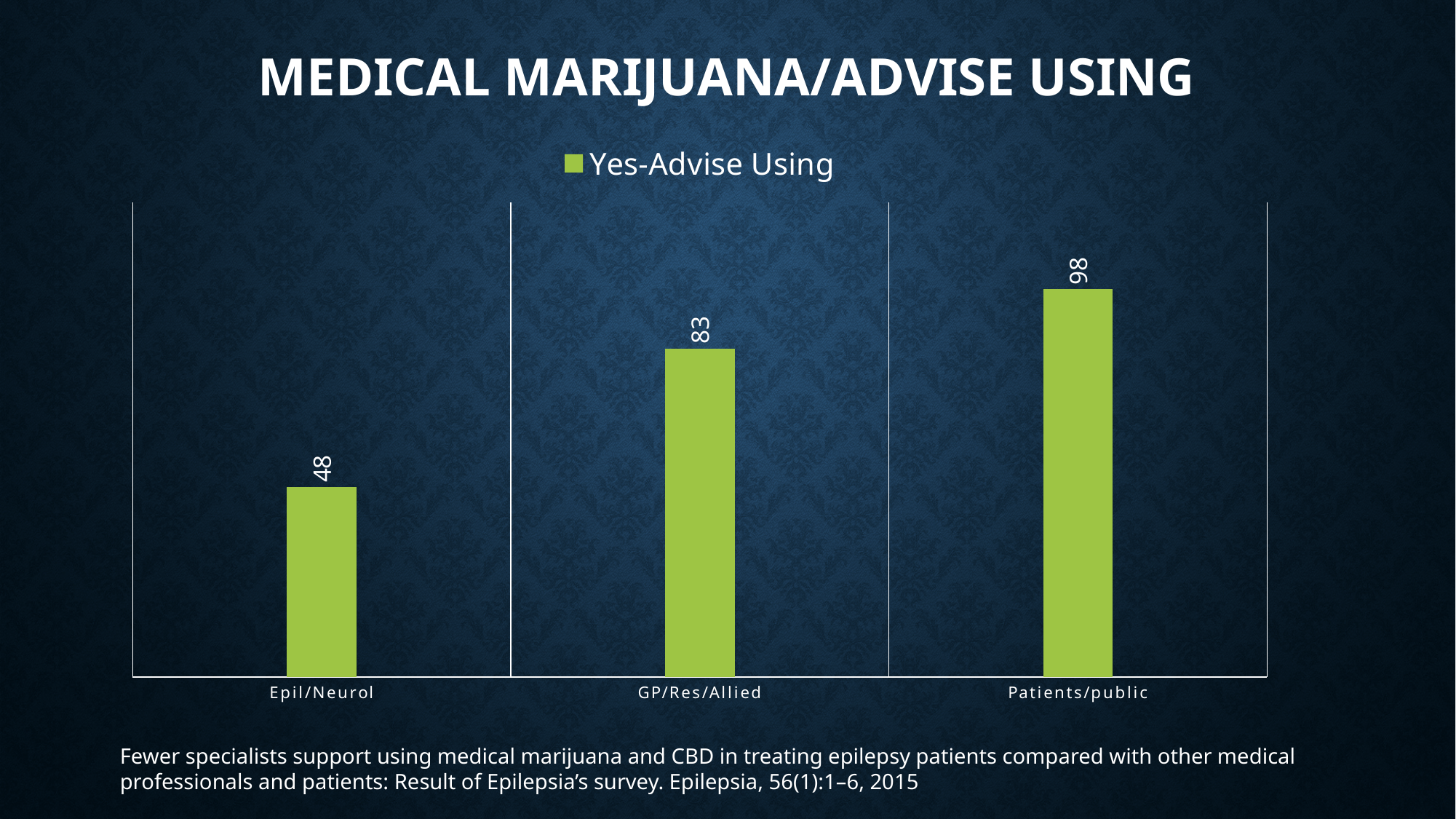
What is the value for GP/Res/Allied? 83 What is the value for Epil/Neurol? 48 Which category has the highest value? Patients/public What is the value for Patients/public? 98 How many series does the legend list? 1 What is the difference between the values for GP/Res/Allied and Epil/Neurol? 35 Which is larger, the value for GP/Res/Allied or the value for Epil/Neurol? GP/Res/Allied How many categories are shown on the x axis? 3 What is the name of the series shown in the legend? Yes-Advise Using What is the difference between the values for Patients/public and Epil/Neurol? 50 Which category has the lowest value? Epil/Neurol What kind of chart is shown on the slide? Bar chart